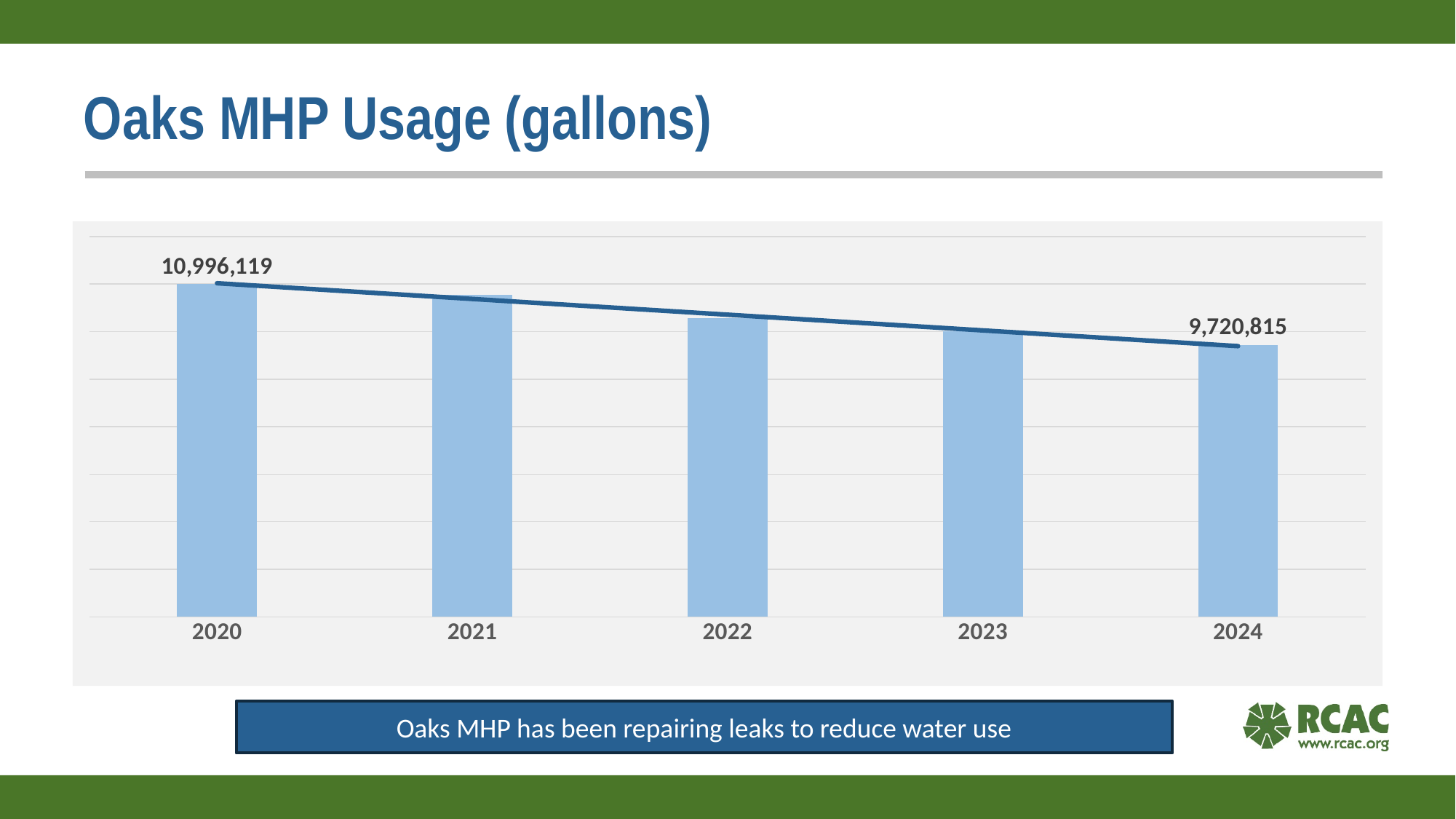
Which year had higher usage, 2022 or 2020? 2020 What was the Oaks MHP usage in gallons in 2024? 9,720,815 What does the text box below the chart say? Oaks MHP has been repairing leaks to reduce water use Which year has the highest usage? 2020 Which year had higher usage, 2021 or 2023? 2021 Do the usage values rise or fall from 2020 to 2024? Fall By how many gallons did usage fall from 2020 to 2024? 1,275,304 What was the Oaks MHP usage in gallons in 2020? 10,996,119 What kind of chart is shown on the slide? Bar chart How many years are shown on the x axis? 5 Which year has the lowest usage? 2024 What is the title of the slide? Oaks MHP Usage (gallons)